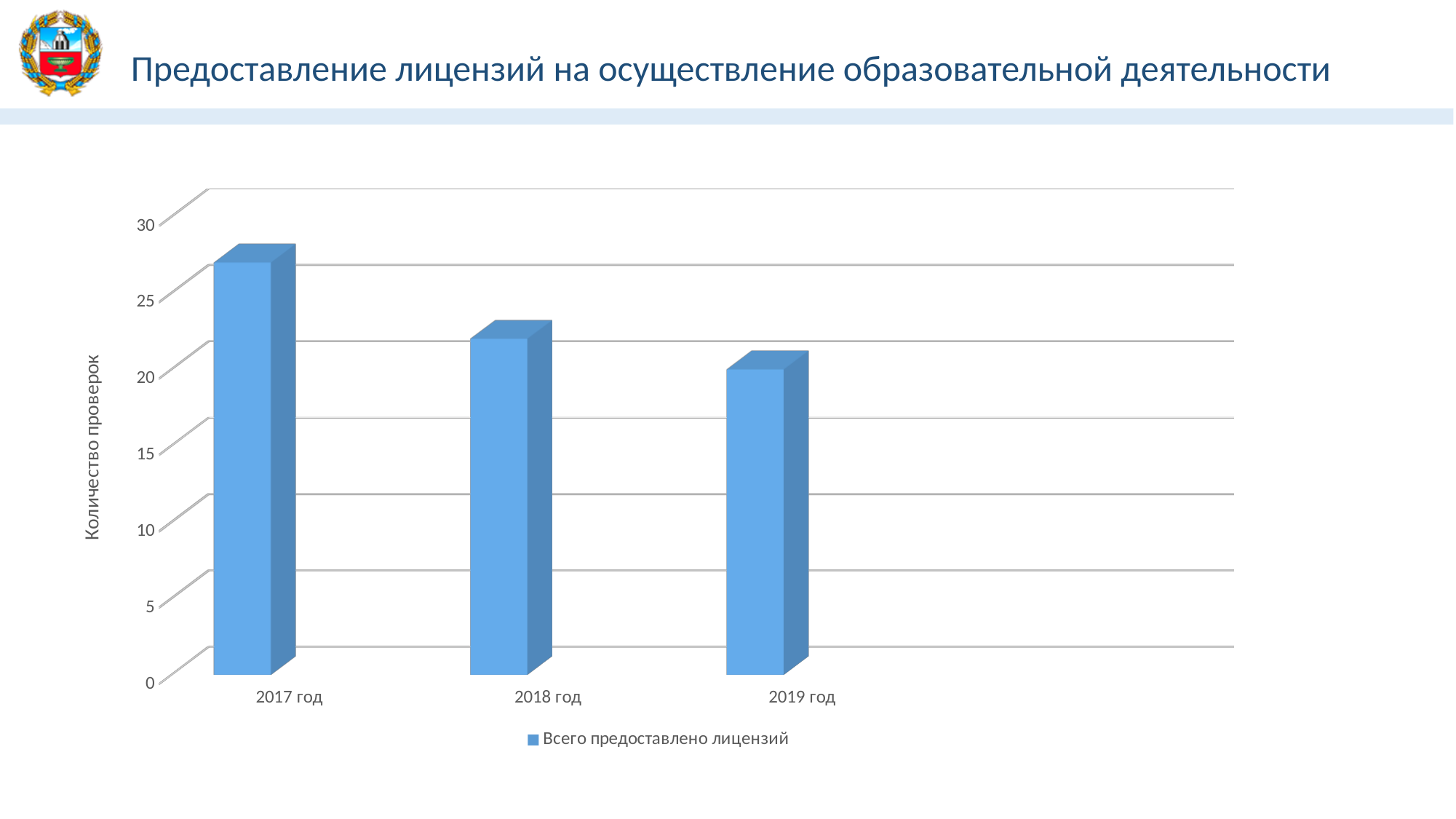
Which is larger, the value for 2017 год or the value for 2018 год? 2017 год Which year has the lowest number of licences granted? 2019 год Do the values rise or fall from 2017 год to 2019 год? fall Is the value for 2019 год greater or less than 15? greater Is the value for 2017 год greater or less than 30? less Which year has the highest number of licences granted? 2017 год Is the value for 2018 год greater or less than 25? less How many series does the legend list? 1 What kind of chart is shown on the slide? bar chart What is the legend entry for the plotted series? Всего предоставлено лицензий How many categories (years) are shown on the x axis? 3